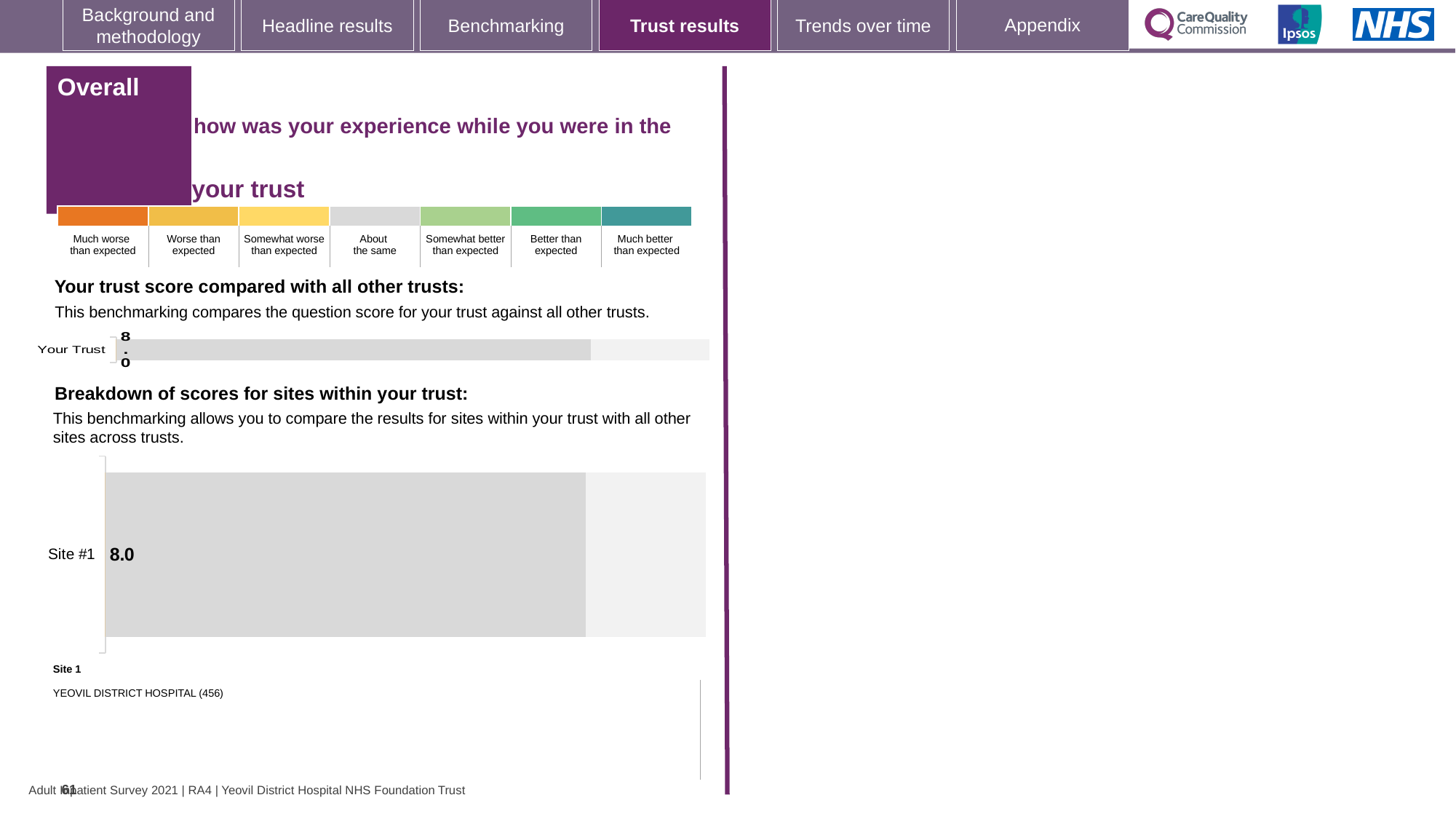
Which hospital is listed as Site 1 below the 'Breakdown of scores for sites within your trust' chart? YEOVIL DISTRICT HOSPITAL (456) In the 'Your trust score compared with all other trusts' chart, what is the score for Your Trust? 8.0 In the 'Breakdown of scores for sites within your trust' chart, what is the score for Site #1? 8.0 Is the score for Your Trust in the 'Your trust score compared with all other trusts' chart greater or less than 10? less Is the score for Site #1 in the 'Breakdown of scores for sites within your trust' chart greater or less than 5? greater How many categories does the colour key above the charts show, from 'Much worse than expected' to 'Much better than expected'? 7 In the 'Your trust score compared with all other trusts' chart, how many categories are plotted? 1 What kind of chart is the 'Breakdown of scores for sites within your trust' chart? bar chart What kind of chart is the 'Your trust score compared with all other trusts' chart? bar chart In the 'Breakdown of scores for sites within your trust' chart, how many sites are plotted? 1